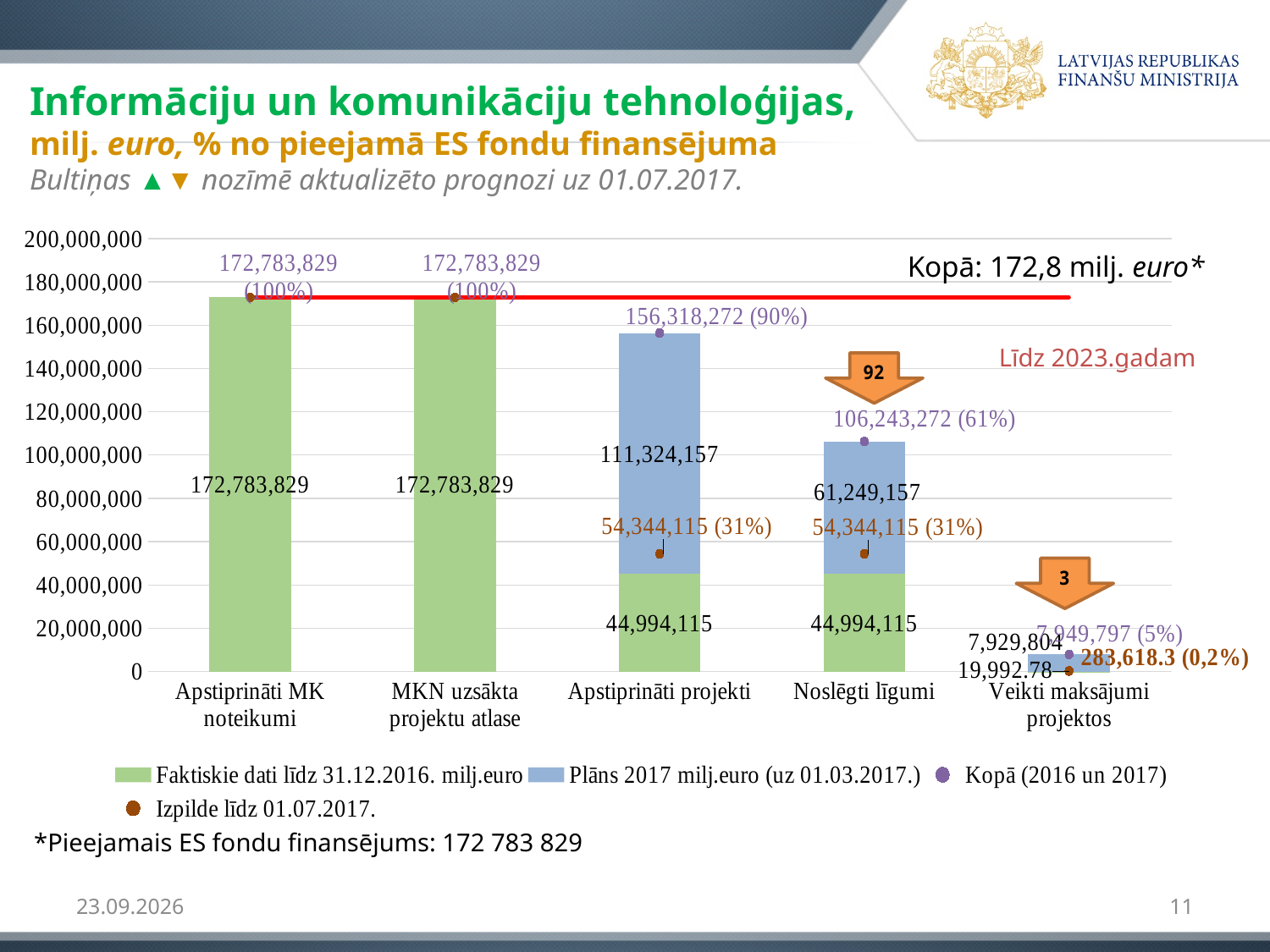
What total is stated in the text label at the top right of the chart? Kopā: 172,8 milj. euro* What is the 'Kopā (2016 un 2017)' value shown for 'Noslēgti līgumi'? 106,243,272 (61%) How many categories are shown on the x axis of the chart? 5 What is the value of the 'Faktiskie dati līdz 31.12.2016. milj.euro' series for 'Veikti maksājumi projektos'? 19,992.78 Is the 'Kopā (2016 un 2017)' value for 'Apstiprināti projekti' greater or less than 140,000,000? greater What is the 'Izpilde līdz 01.07.2017.' value shown for 'Apstiprināti projekti'? 54,344,115 (31%) What is the difference between the 'Plāns 2017 milj.euro (uz 01.03.2017.)' values for 'Apstiprināti projekti' and 'Noslēgti līgumi'? 50,075,000 How many series does the chart legend list? 4 Which category has the lowest 'Kopā (2016 un 2017)' value? Veikti maksājumi projektos What is the value of the 'Plāns 2017 milj.euro (uz 01.03.2017.)' series for 'Apstiprināti projekti'? 111,324,157 What kind of chart is shown on the slide? Combination chart: stacked bar chart with a line and point markers Which category has the larger 'Plāns 2017 milj.euro (uz 01.03.2017.)' value: 'Apstiprināti projekti' or 'Noslēgti līgumi'? Apstiprināti projekti